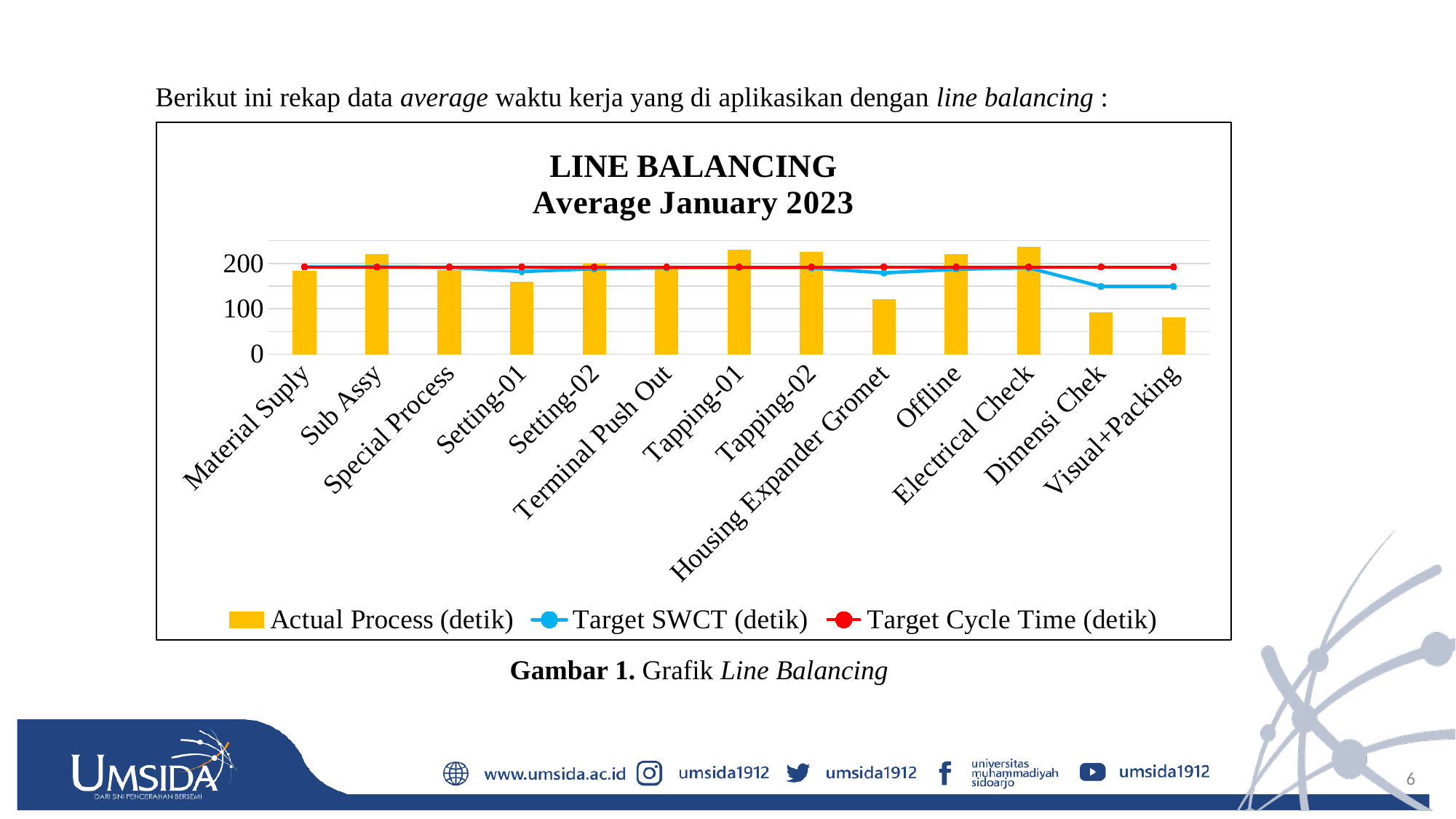
What kind of chart is shown on the slide? Combination bar and line chart Which has the larger Actual Process (detik) value, Sub Assy or Setting-01? Sub Assy How many categories are shown on the x axis of the chart? 13 Which category has the lowest Actual Process (detik) bar? Visual+Packing Is the Actual Process (detik) value for Setting-01 greater or less than 200? less How many series does the chart legend list? 3 Is the Actual Process (detik) value for Electrical Check greater or less than 200? greater Is the Actual Process (detik) value for Housing Expander Gromet greater or less than 100? greater Does the Target SWCT (detik) line rise or fall over the last two categories (Dimensi Chek and Visual+Packing) compared with Electrical Check? fall Which category has the highest Actual Process (detik) bar? Electrical Check What is the title of the chart? LINE BALANCING Average January 2023